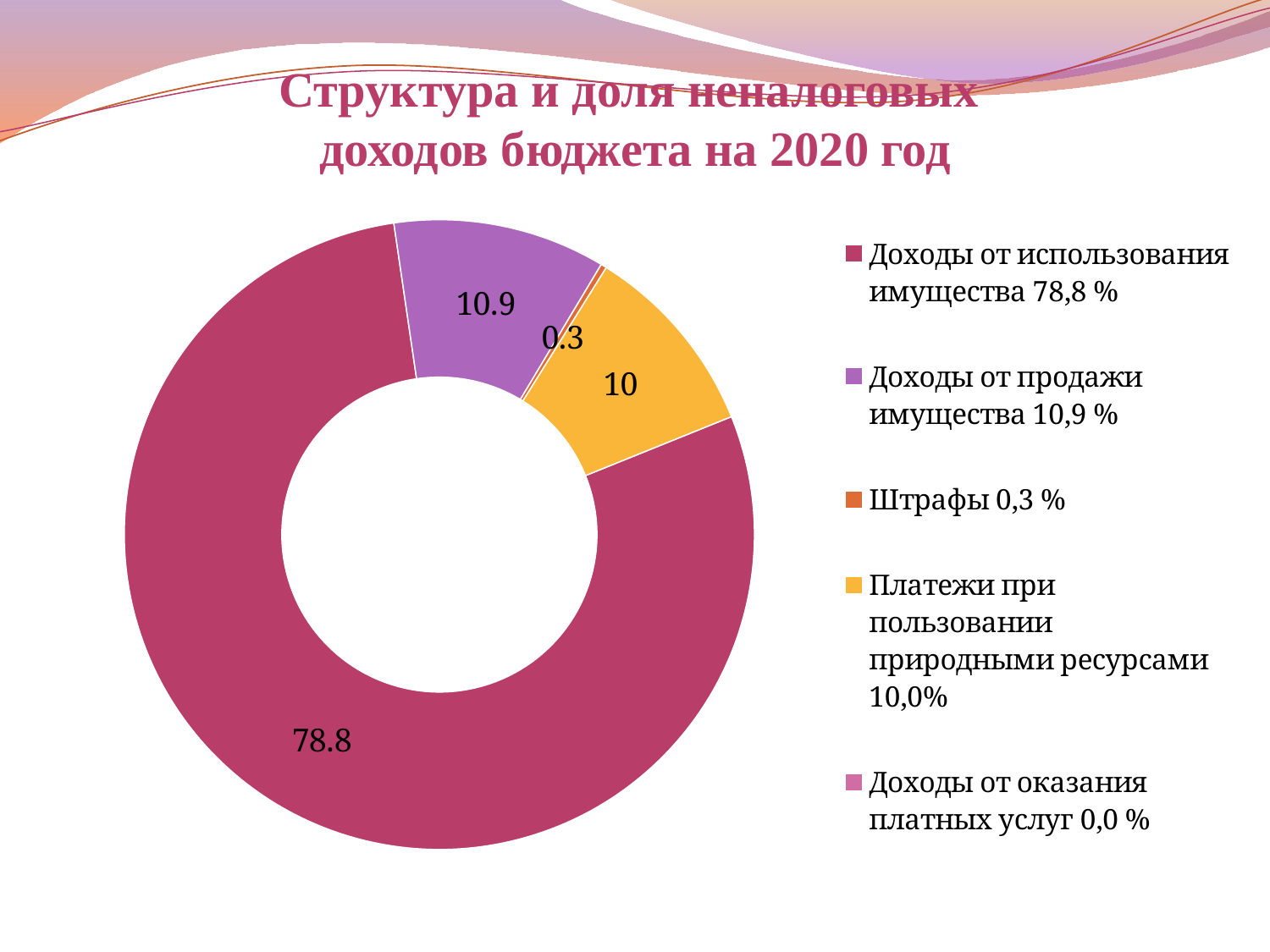
What is the title of the chart on the slide? Структура и доля неналоговых доходов бюджета на 2020 год What is the data label shown for the largest slice of the chart? 78.8 How many entries does the legend list? 5 What type of chart is shown on the slide? Doughnut (pie) chart Which is larger: the slice for Доходы от продажи имущества or the slice for Платежи при пользовании природными ресурсами? Доходы от продажи имущества Which category with a non-zero value has the smallest share of the chart? Штрафы What is the difference between the labelled values for Доходы от использования имущества and Доходы от продажи имущества? 67.9 What share does the legend give for Доходы от оказания платных услуг? 0,0 % What value is labelled on the yellow slice (Платежи при пользовании природными ресурсами)? 10 What value is labelled on the purple slice (Доходы от продажи имущества)? 10.9 What value is labelled on the slice for Штрафы? 0.3 Which category has the largest share of the chart? Доходы от использования имущества